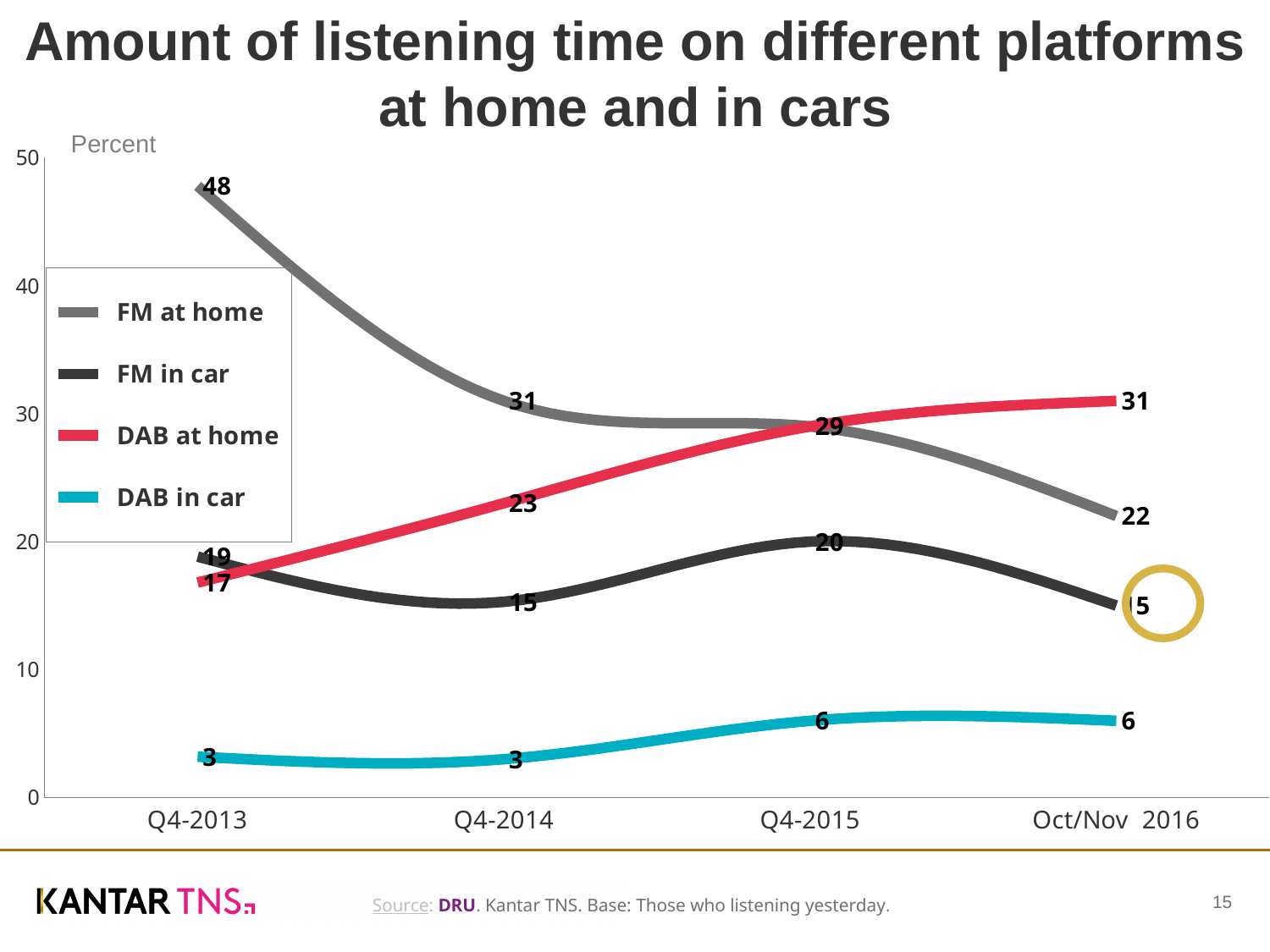
Which is larger in Oct/Nov 2016, DAB at home or FM at home? DAB at home What is the value for DAB in car in Q4-2014? 3 How many series does the legend list? 4 What is the difference between FM at home in Q4-2013 and in Oct/Nov 2016? 26 What type of chart is shown on the slide? line chart What is the value for FM at home in Q4-2013? 48 How many time points are shown on the x axis? 4 What is the value for FM in car in Q4-2015? 20 What is the value for DAB at home in Oct/Nov 2016? 31 Which series has the lowest value in Oct/Nov 2016? DAB in car Which series has the highest value in Q4-2013? FM at home Does the DAB at home series rise or fall from Q4-2013 to Oct/Nov 2016? rise